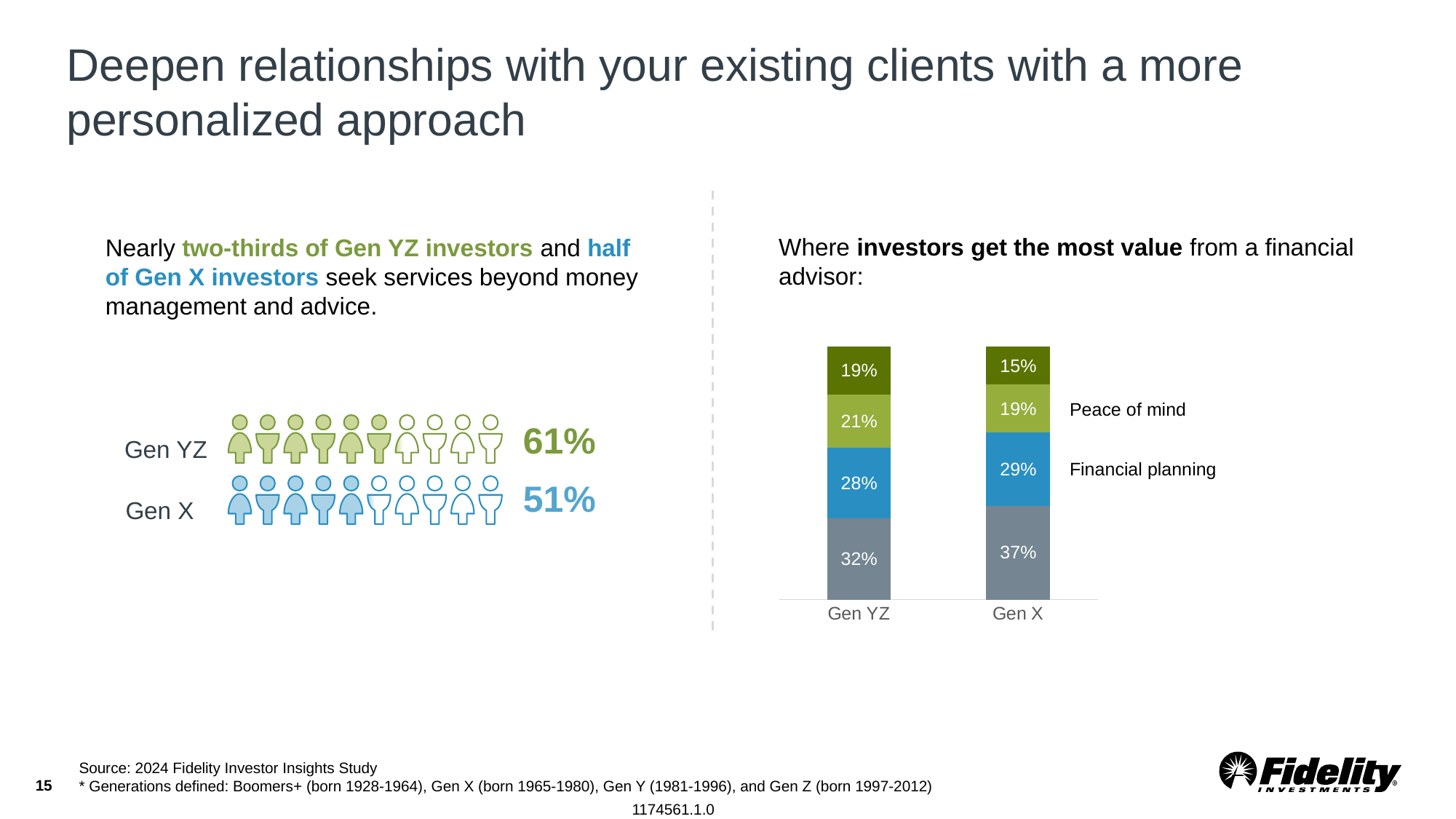
In the stacked bar chart on the right, what is the Financial planning value for Gen YZ? 28% In the stacked bar chart on the right, what is the difference between the Peace of mind values for Gen YZ and Gen X? 2 percentage points In the stacked bar chart on the right, what is the Peace of mind value for Gen X? 19% In the pictogram on the left, what is the difference between the Gen YZ and Gen X percentages? 10 percentage points In the stacked bar chart on the right, which generation has the larger Financial planning value, Gen YZ or Gen X? Gen X In the stacked bar chart on the right, which generation has the larger Peace of mind value, Gen YZ or Gen X? Gen YZ In the pictogram on the left, what percentage is shown for Gen YZ? 61% In the stacked bar chart on the right, what is the Financial planning value for Gen X? 29% In the stacked bar chart on the right, what is the Peace of mind value for Gen YZ? 21% In the stacked bar chart on the right, what is the total of all segments in the Gen YZ bar? 100% What kind of chart is shown on the right side of the slide? Stacked bar chart How many categories are shown on the x axis of the stacked bar chart on the right? 2